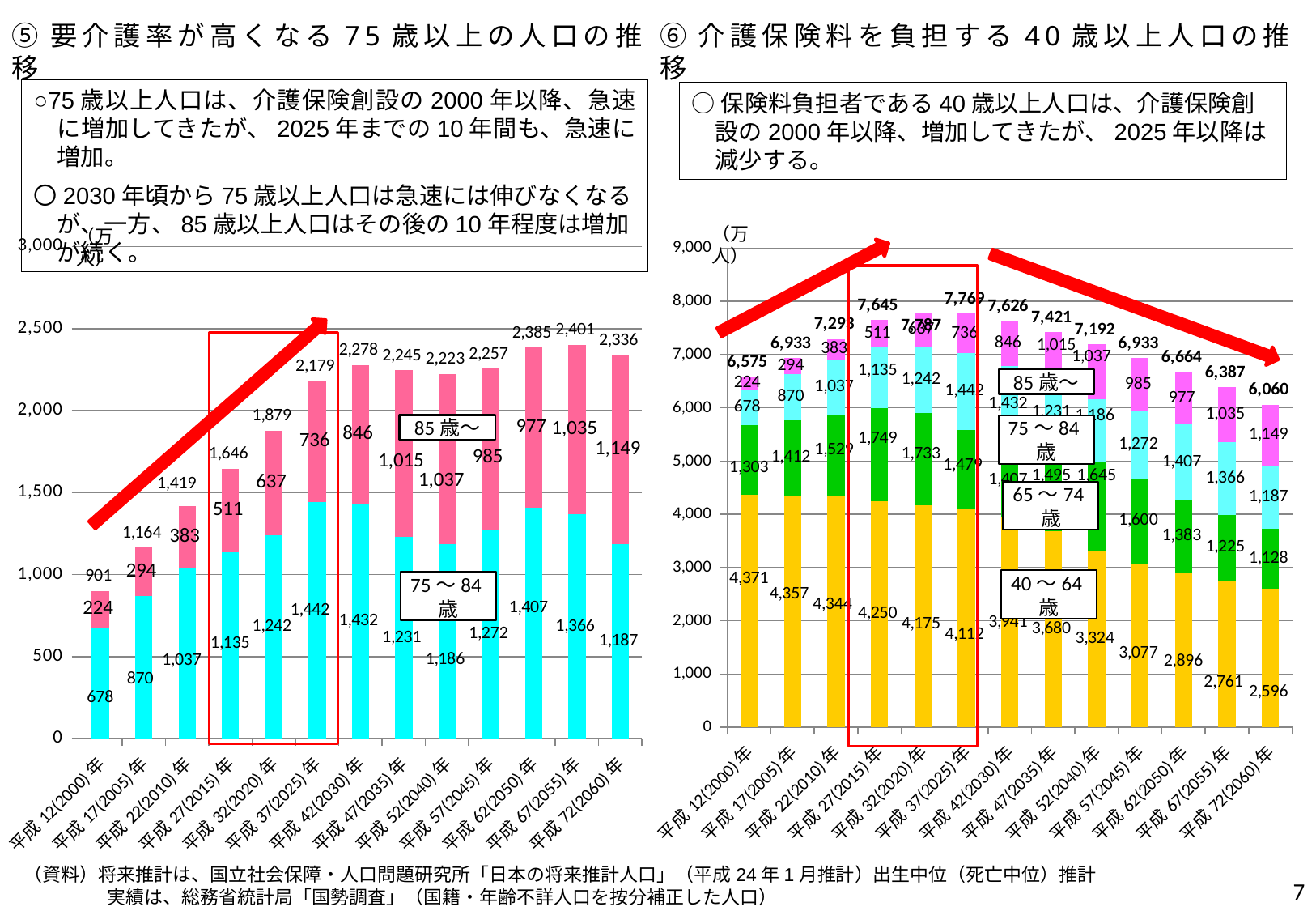
What kind of chart is the left chart (⑤ 75歳以上の人口の推移)? Stacked bar chart In the left chart (⑤), what is the difference between the totals for 平成37(2025)年 and 平成27(2015)年? 533 In the left chart (⑤), which year has the highest total? 平成67(2055)年 How many age-group series are stacked in the right chart (⑥)? 4 In the right chart (⑥ 40歳以上人口の推移), what is the 40〜64歳 value for 平成72(2060)年? 2,596 In the right chart (⑥), is the 40〜64歳 value larger in 平成12(2000)年 or 平成72(2060)年? 平成12(2000)年 In the left chart (⑤), what is the total 75歳以上 population for 平成37(2025)年? 2,179 How many years (categories) are shown on the x axis of the left chart (⑤)? 13 In the right chart (⑥), which year has the highest total? 平成32(2020)年 In the left chart (⑤), what is the 85歳〜 value for 平成72(2060)年? 1,149 In the right chart (⑥), does the 40〜64歳 series rise or fall from 平成12(2000)年 to 平成72(2060)年? Fall In the left chart (⑤), which year has the lowest total? 平成12(2000)年